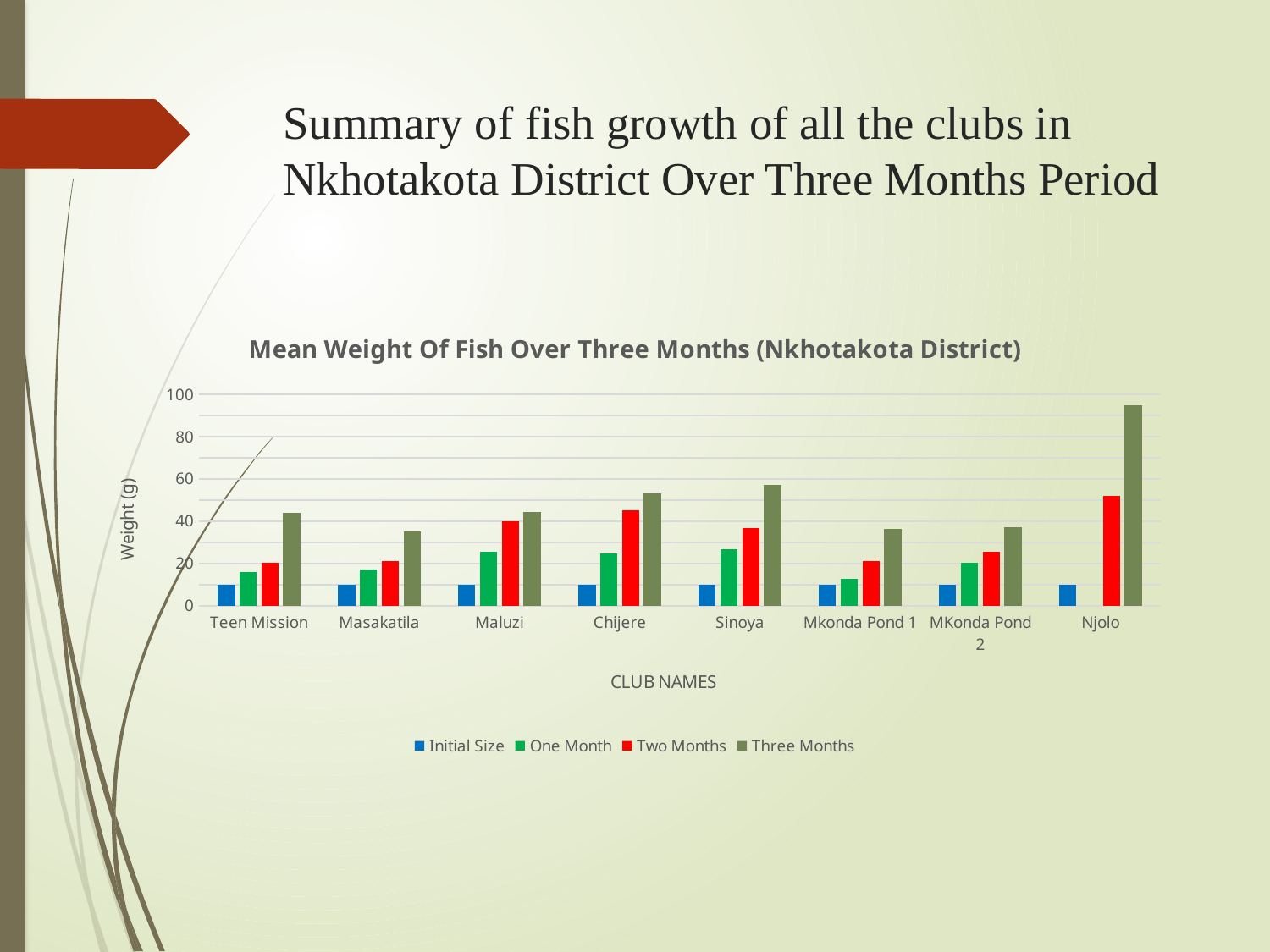
How many series does the chart's legend list? 4 Is the Three Months value for Teen Mission greater or less than 40? greater Which is larger, the Three Months value for Sinoya or the Three Months value for Masakatila? Sinoya What is the title of the chart? Mean Weight Of Fish Over Three Months (Nkhotakota District) Is the Initial Size value for Maluzi greater or less than 20? less What is the label of the chart's y axis? Weight (g) Is the Two Months value for Masakatila greater or less than 40? less For Chijere, do the values rise or fall from Initial Size through Three Months? rise What kind of chart is shown on the slide? bar chart How many clubs are shown along the x axis of the chart? 8 Which club has the highest Three Months mean weight? Njolo